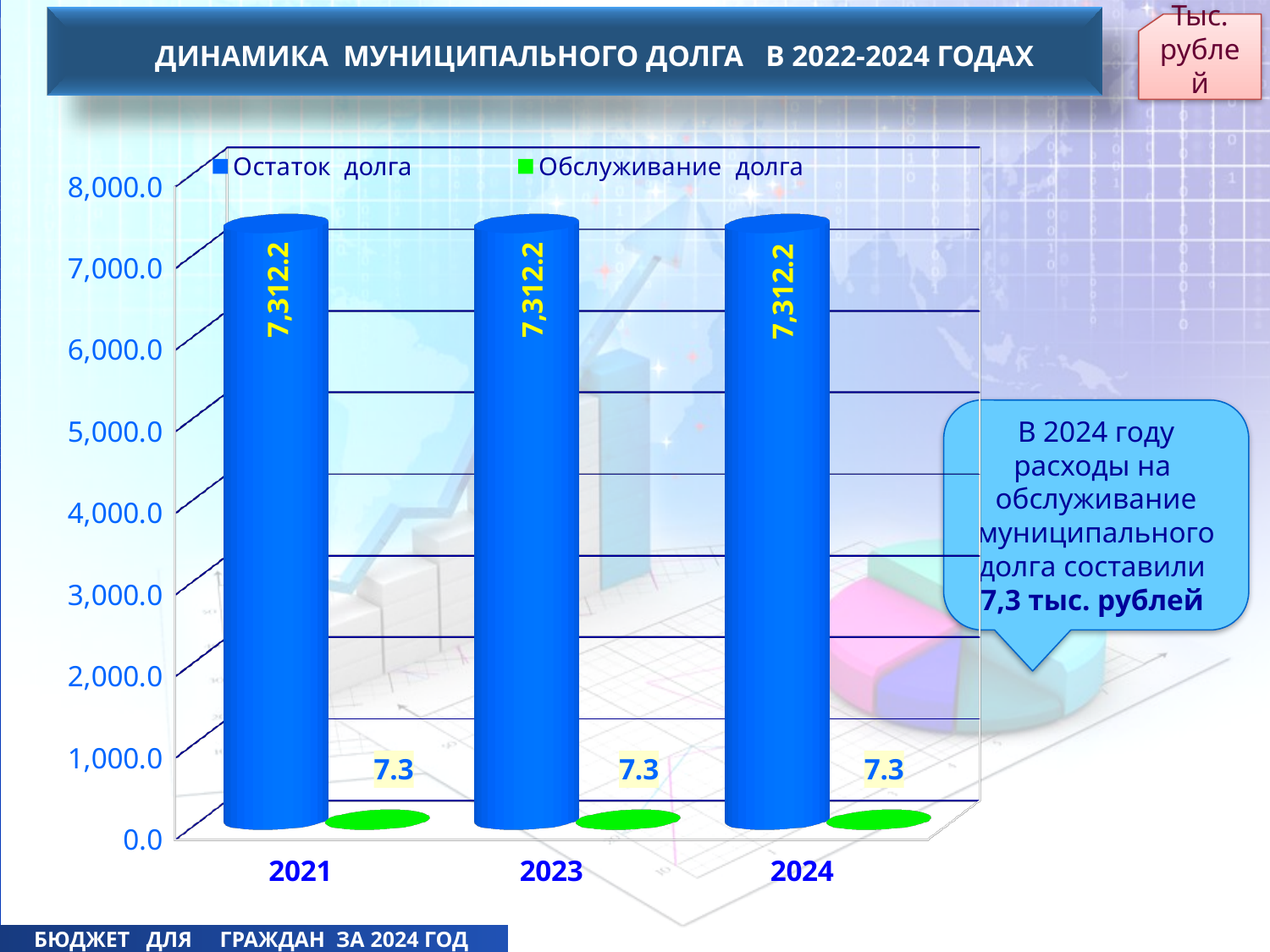
Is the value of Остаток долга for 2023 greater or less than 7,000.0? greater What is the title of the chart? ДИНАМИКА МУНИЦИПАЛЬНОГО ДОЛГА В 2022-2024 ГОДАХ Which series has the larger value in 2023, Остаток долга or Обслуживание долга? Остаток долга What is the value of Обслуживание долга for 2023? 7.3 What kind of chart is shown on the slide? bar chart What is the value of Остаток долга for 2024? 7,312.2 How many series does the legend list? 2 What is the difference between Остаток долга and Обслуживание долга in 2024? 7,304.9 Does the value of Остаток долга rise, fall, or stay the same from 2021 to 2024? stays the same What is the value of Обслуживание долга for 2024? 7.3 How many categories (years) are shown on the x axis? 3 What is the value of Остаток долга for 2021? 7,312.2